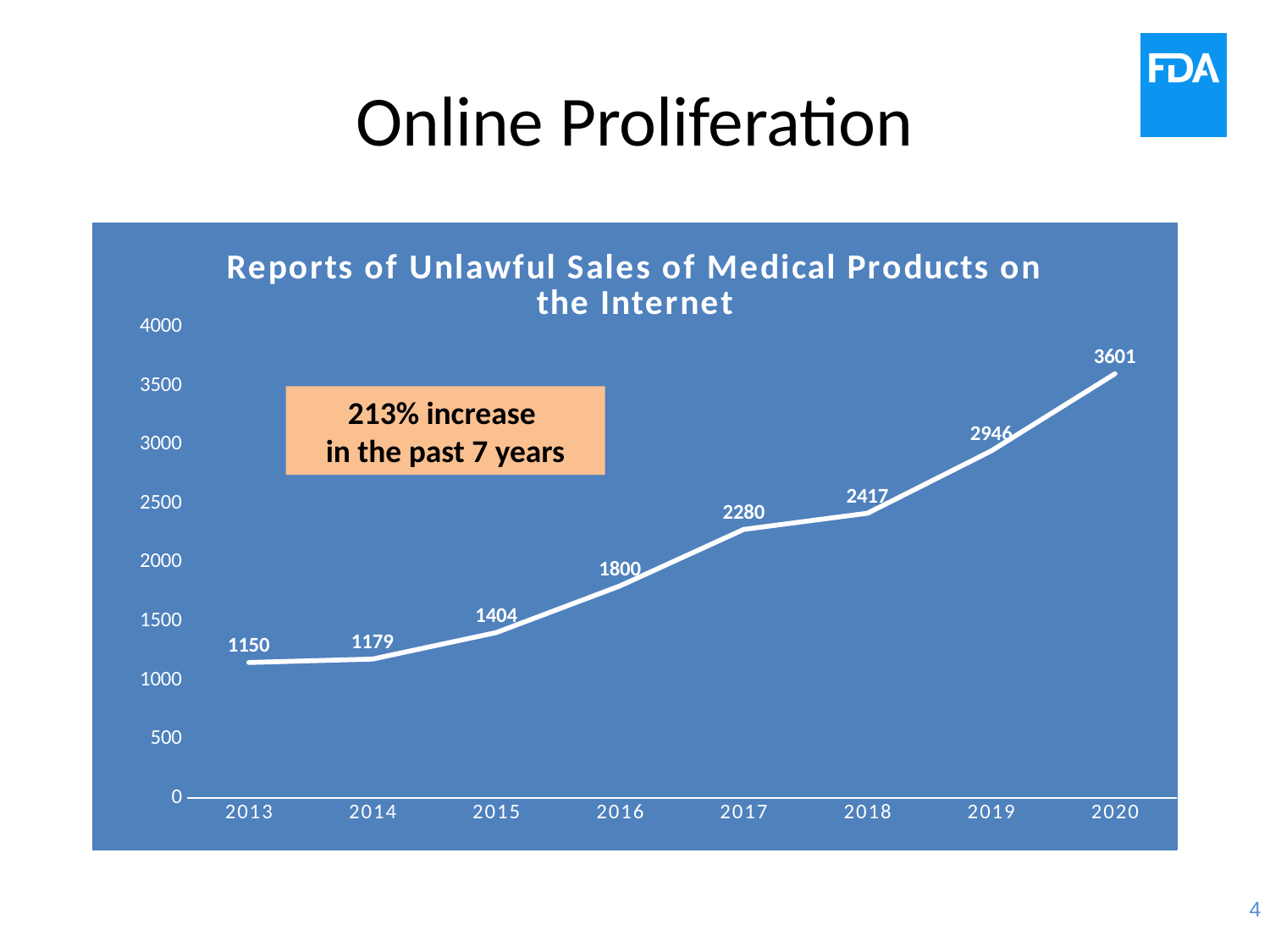
What is the difference between the values for 2020 and 2019? 655 What is the difference between the values for 2014 and 2013? 29 Which year has the highest value? 2020 Which year has the lowest value? 2013 Which is larger, the value for 2016 or the value for 2018? 2018 Is the value for 2019 greater or less than 2500? greater What is the value for 2017? 2280 What kind of chart is shown? line chart Do the values rise or fall from 2013 to 2020? rise How many years are plotted on the x axis? 8 What is the value for 2020? 3601 What is the value for 2013? 1150